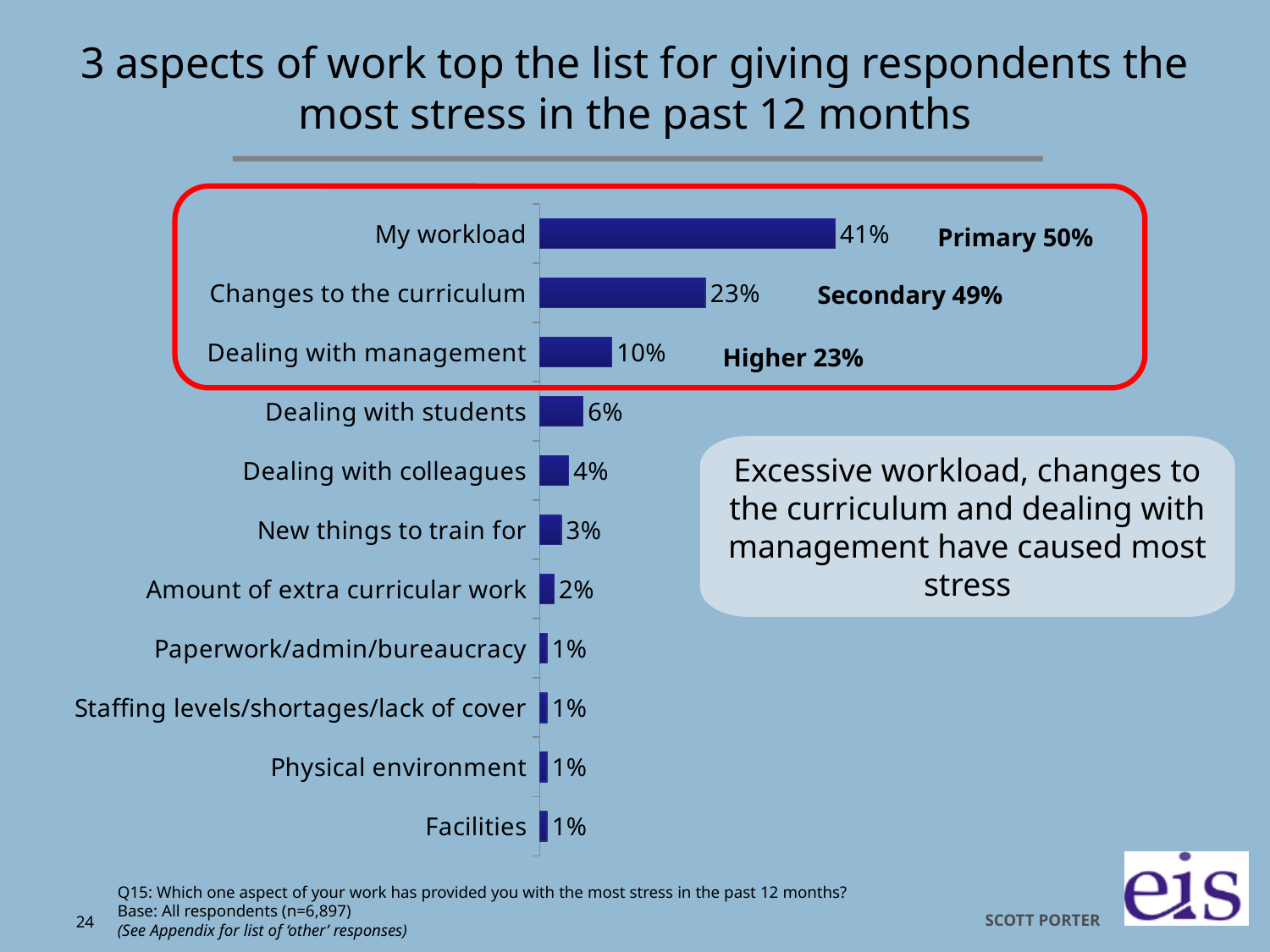
What percentage of respondents said 'My workload' gave them the most stress? 41% What is the value shown for 'Changes to the curriculum'? 23% What is the value shown for 'Dealing with management'? 10% What is the value shown for 'Facilities'? 1% What kind of chart is shown on the slide? Bar chart What is the difference in percentage points between 'My workload' and 'Changes to the curriculum'? 18 How many categories are plotted in the chart? 11 According to the annotation next to the chart, what percentage of Primary respondents cited workload as their main stress? 50% Which aspect of work has the highest percentage in the chart? My workload What is the value shown for 'Amount of extra curricular work'? 2% Which is larger, the value for 'Dealing with colleagues' or the value for 'New things to train for'? Dealing with colleagues What is the value shown for 'Dealing with students'? 6%